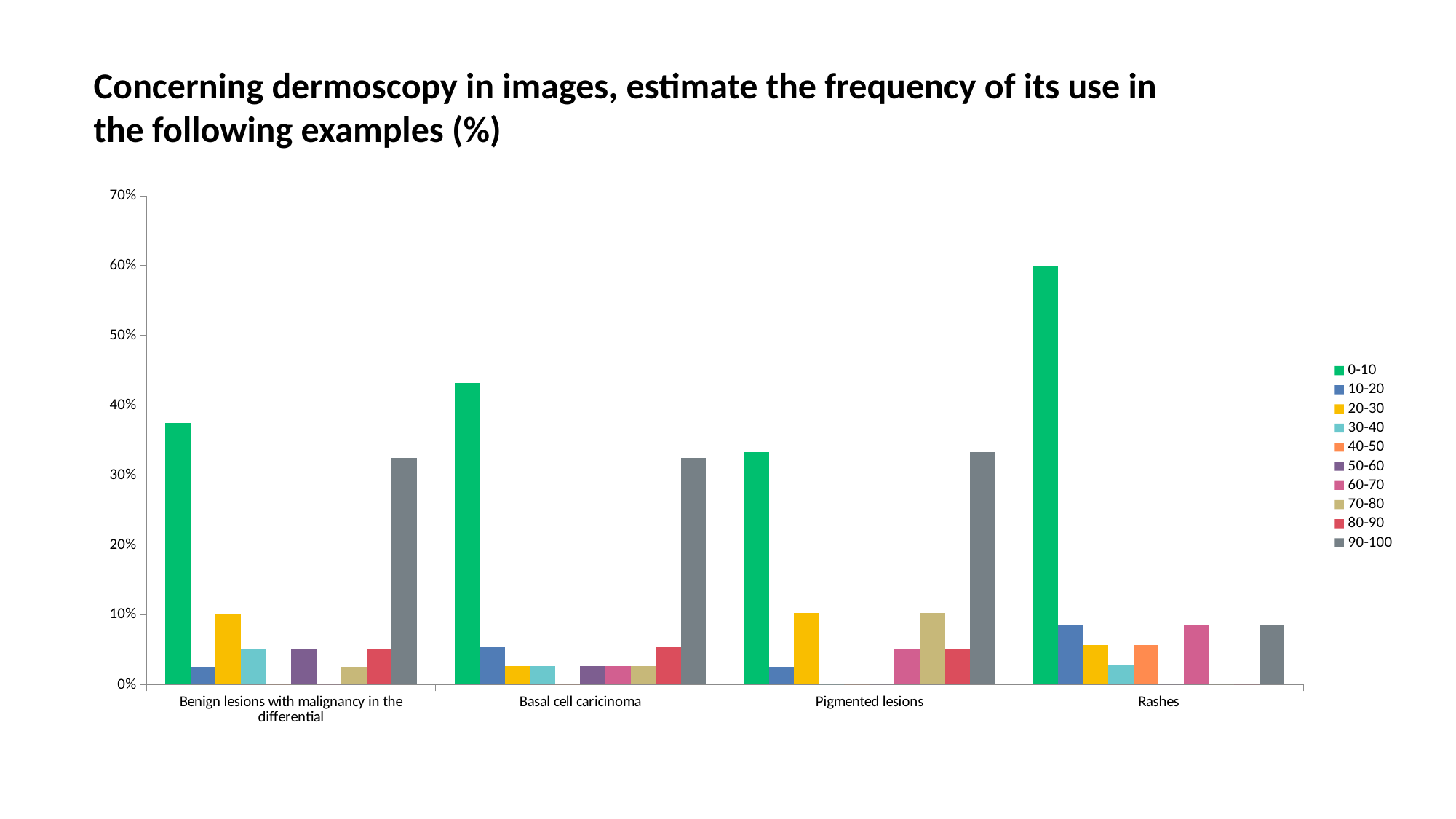
For Benign lesions with malignancy in the differential, which is larger: the 0-10 series or the 90-100 series? 0-10 Is the value for the 0-10 series for Rashes greater or less than 50%? greater Is the value for the 90-100 series for Rashes greater or less than 10%? less Is the value for the 90-100 series for Benign lesions with malignancy in the differential greater or less than 30%? greater What kind of chart is shown on the slide? bar chart Which category has the highest value for the 0-10 series? Rashes What is the title of the chart? Concerning dermoscopy in images, estimate the frequency of its use in the following examples (%) Which is larger: the 0-10 value for Rashes or the 0-10 value for Basal cell caricinoma? Rashes Which category has the lowest value for the 90-100 series? Rashes How many example categories are shown along the x axis? 4 How many series does the legend list? 10